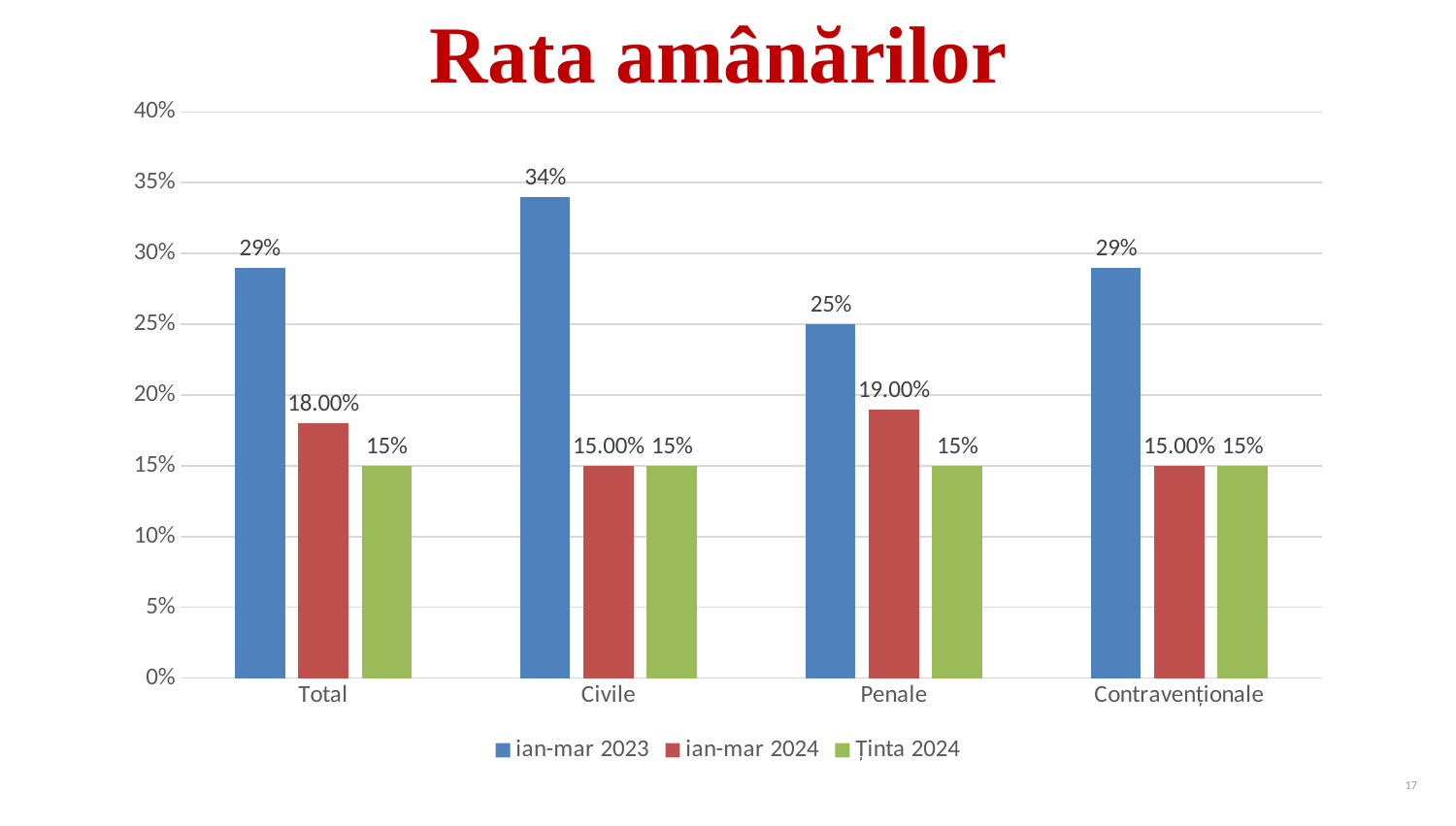
Which category has the highest value in the ian-mar 2023 series? Civile Which category has the lowest value in the ian-mar 2023 series? Penale What is the value for Total in the ian-mar 2024 series? 18.00% Which is larger for Penale: the ian-mar 2023 value or the ian-mar 2024 value? ian-mar 2023 How many series does the legend list? 3 How many categories are shown on the x axis? 4 What is the value for Civile in the ian-mar 2023 series? 34% What is the difference between the ian-mar 2023 and ian-mar 2024 values for Civile? 19% What is the value for Penale in the ian-mar 2024 series? 19.00% What is the Ținta 2024 value for Contravenționale? 15% What is the title of the chart? Rata amânărilor What kind of chart is shown on the slide? Bar chart